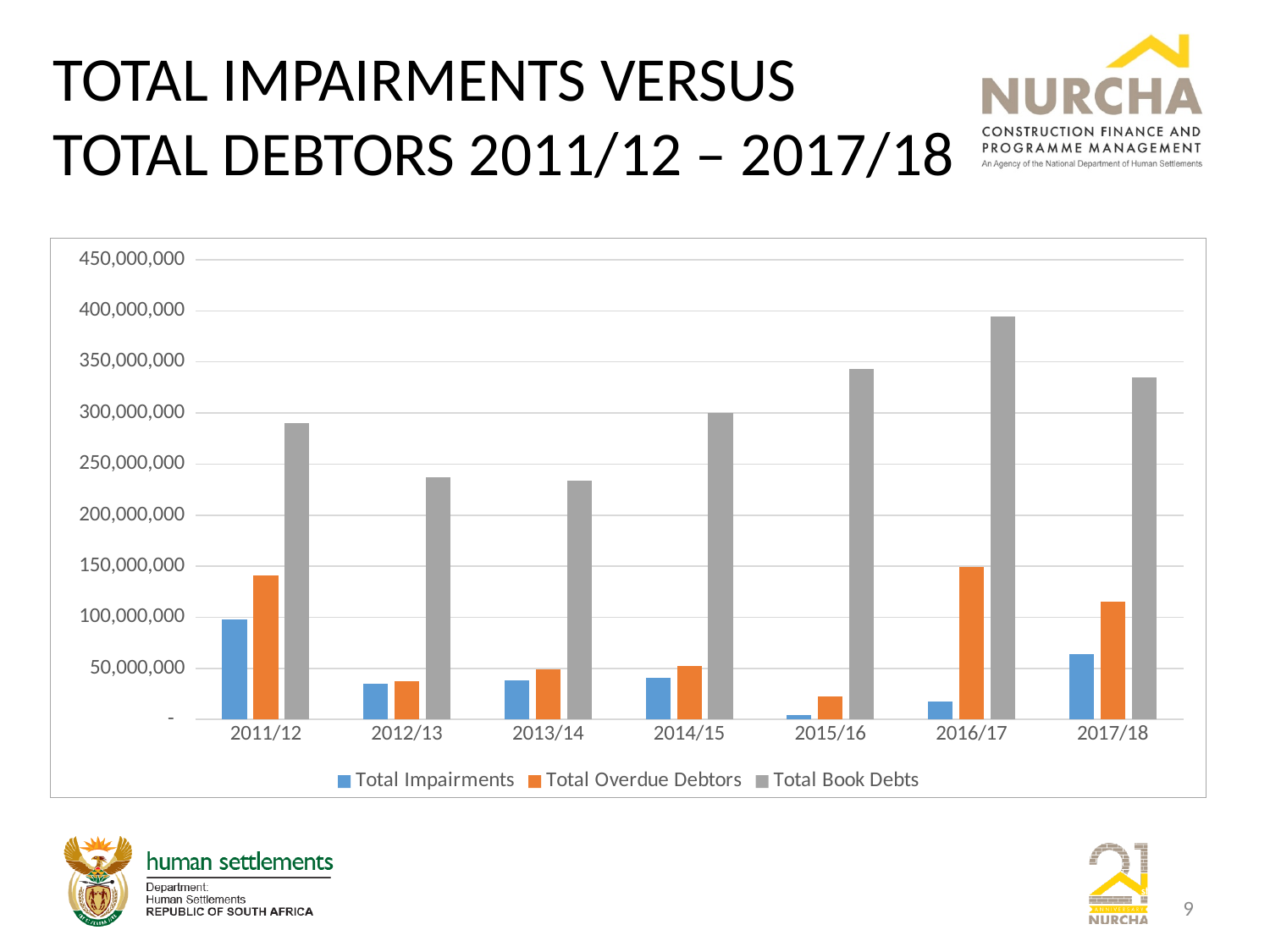
Is the value for Total Overdue Debtors in 2016/17 greater or less than 100,000,000? greater In which year is Total Overdue Debtors highest? 2016/17 Is the value for Total Book Debts in 2016/17 greater or less than 350,000,000? greater What colour represents Total Book Debts in the legend? grey What kind of chart is shown on the slide? bar chart In which year is Total Impairments lowest? 2015/16 How many financial years are shown on the x axis? 7 Is the value for Total Impairments in 2015/16 greater or less than 50,000,000? less Which is larger: Total Overdue Debtors in 2011/12 or Total Overdue Debtors in 2017/18? 2011/12 Do the Total Book Debts values rise or fall from 2014/15 to 2016/17? rise In which year is Total Book Debts highest? 2016/17 How many series does the legend list? 3